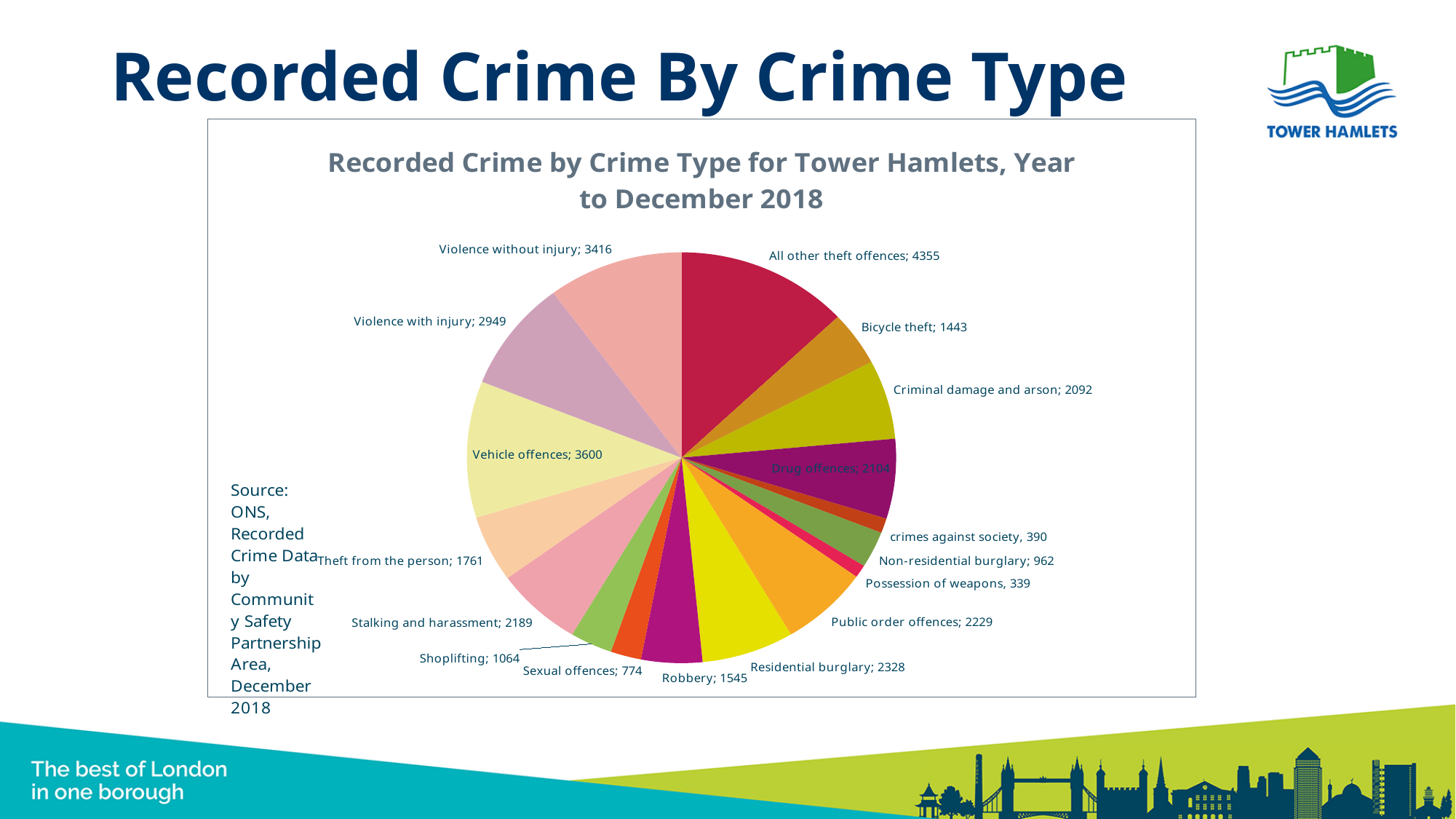
What is the value for Stalking and harassment? 2189 What is the difference between Residential burglary and Public order offences? 99 What is the value for Non-residential burglary? 962 Which crime type has the highest recorded value? All other theft offences Which crime type has the lowest recorded value? Possession of weapons What kind of chart is shown on the slide? Pie chart What is the title of the chart? Recorded Crime by Crime Type for Tower Hamlets, Year to December 2018 What is the value for Residential burglary? 2328 What is the difference between Vehicle offences and Violence without injury? 184 What is the value for Vehicle offences? 3600 Which is larger, Violence with injury or Theft from the person? Violence with injury How many crime types are shown in the pie chart? 17